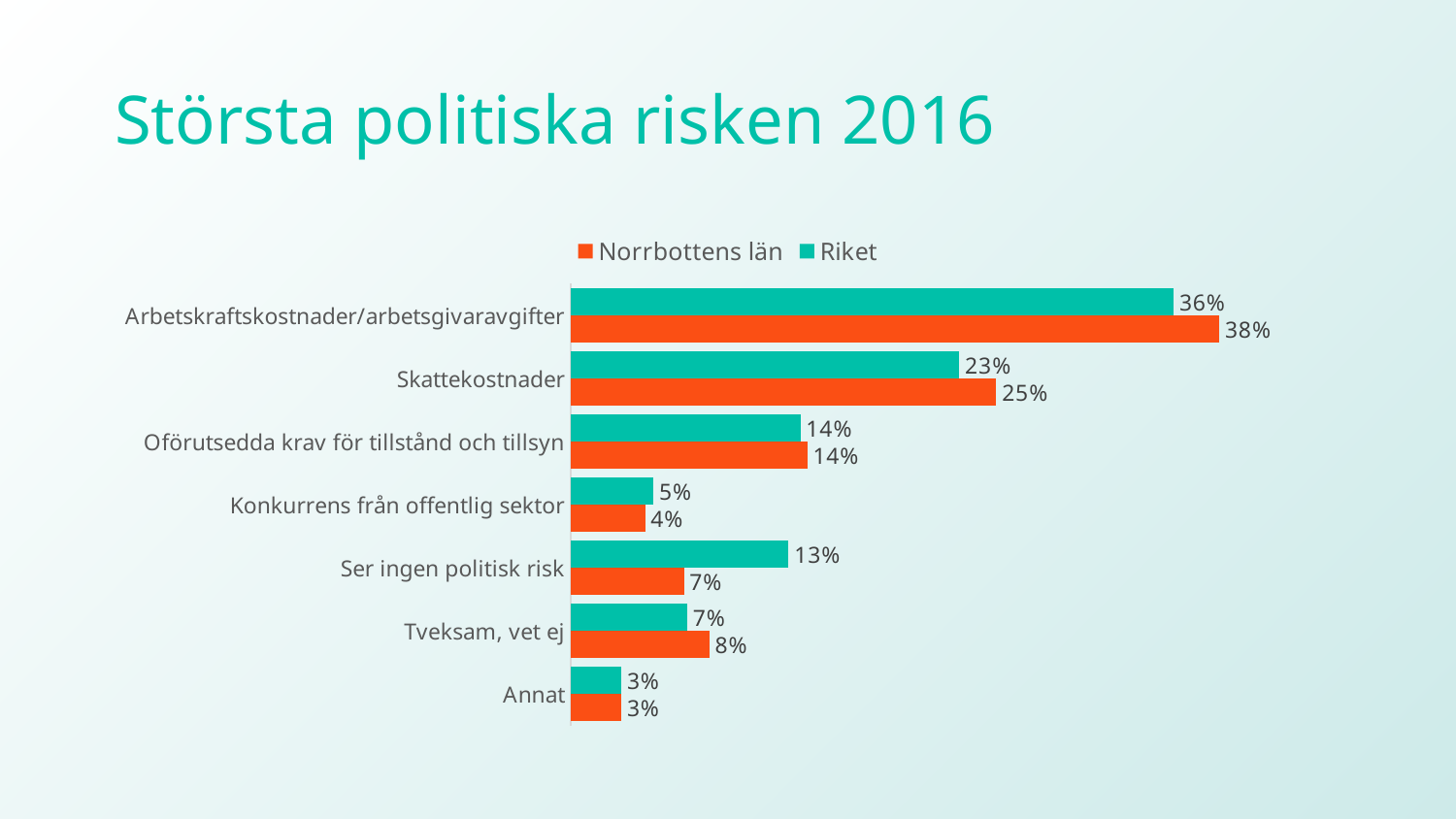
How many series does the legend list? 2 Which category has the lowest value for Norrbottens län? Annat What is the value for Norrbottens län in the category Ser ingen politisk risk? 7% What is the title of the slide? Största politiska risken 2016 What is the value for Norrbottens län in the category Arbetskraftskostnader/arbetsgivaravgifter? 38% Which series has the larger value in the category Konkurrens från offentlig sektor, Norrbottens län or Riket? Riket How many categories are shown in the chart? 7 What is the value for Riket in the category Skattekostnader? 23% Which category has the highest value for Riket? Arbetskraftskostnader/arbetsgivaravgifter What kind of chart is shown on the slide? Bar chart What is the difference between Norrbottens län and Riket in the category Skattekostnader? 2% What is the difference between Norrbottens län and Riket in the category Ser ingen politisk risk? 6%